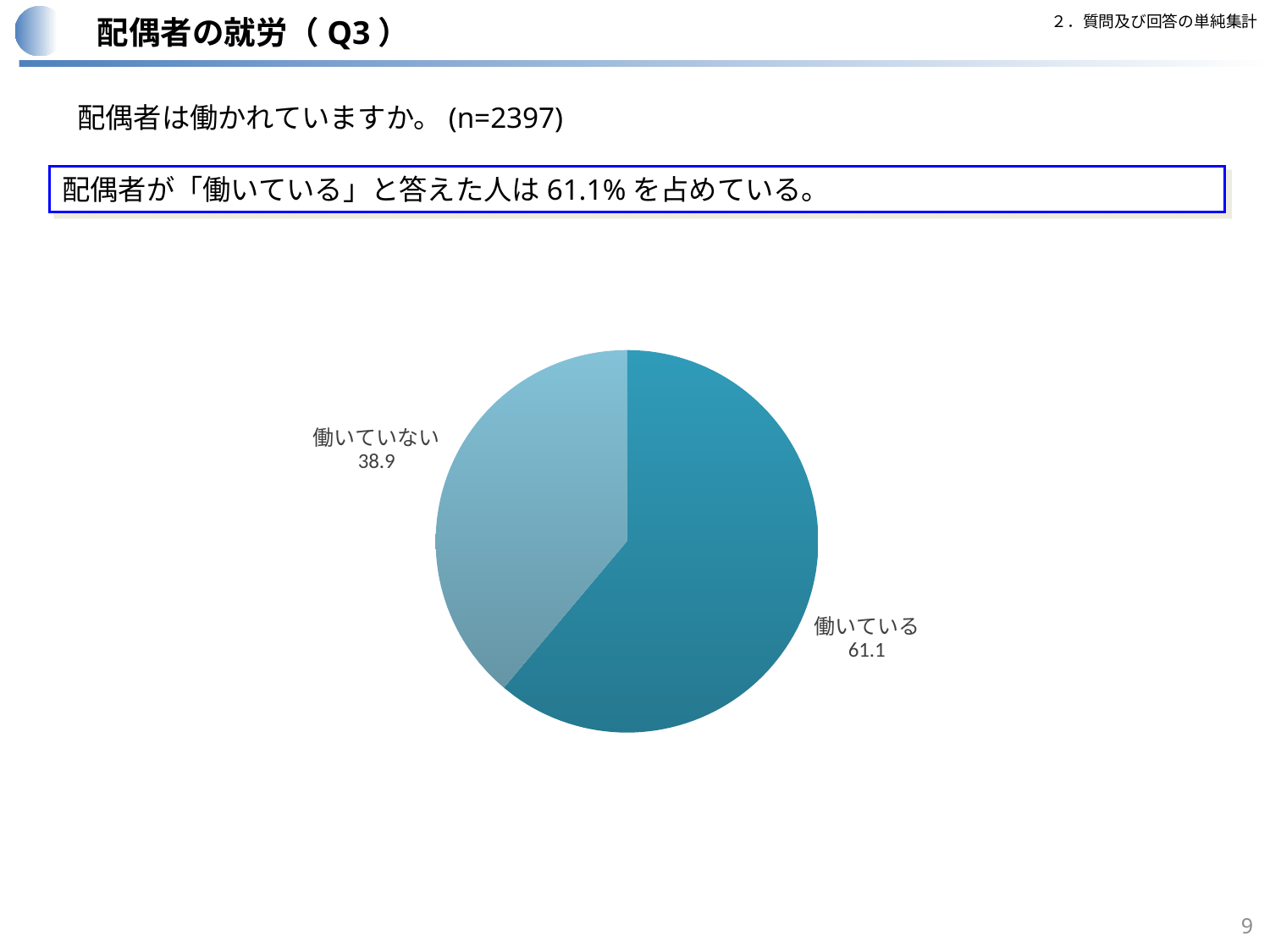
What kind of chart is shown on the slide? pie chart What is the value for 働いていない? 38.9 How many slices does the pie chart have? 2 Which category has the largest slice? 働いている Which is larger, the value for 働いている or the value for 働いていない? 働いている Which category has the smallest slice? 働いていない What is the difference between the values for 働いている and 働いていない? 22.2 What is the total of the two slice values? 100 What is the sample size (n) stated on the slide? 2397 Which slice is drawn in the darker shade of blue? 働いている What is the value for 働いている? 61.1